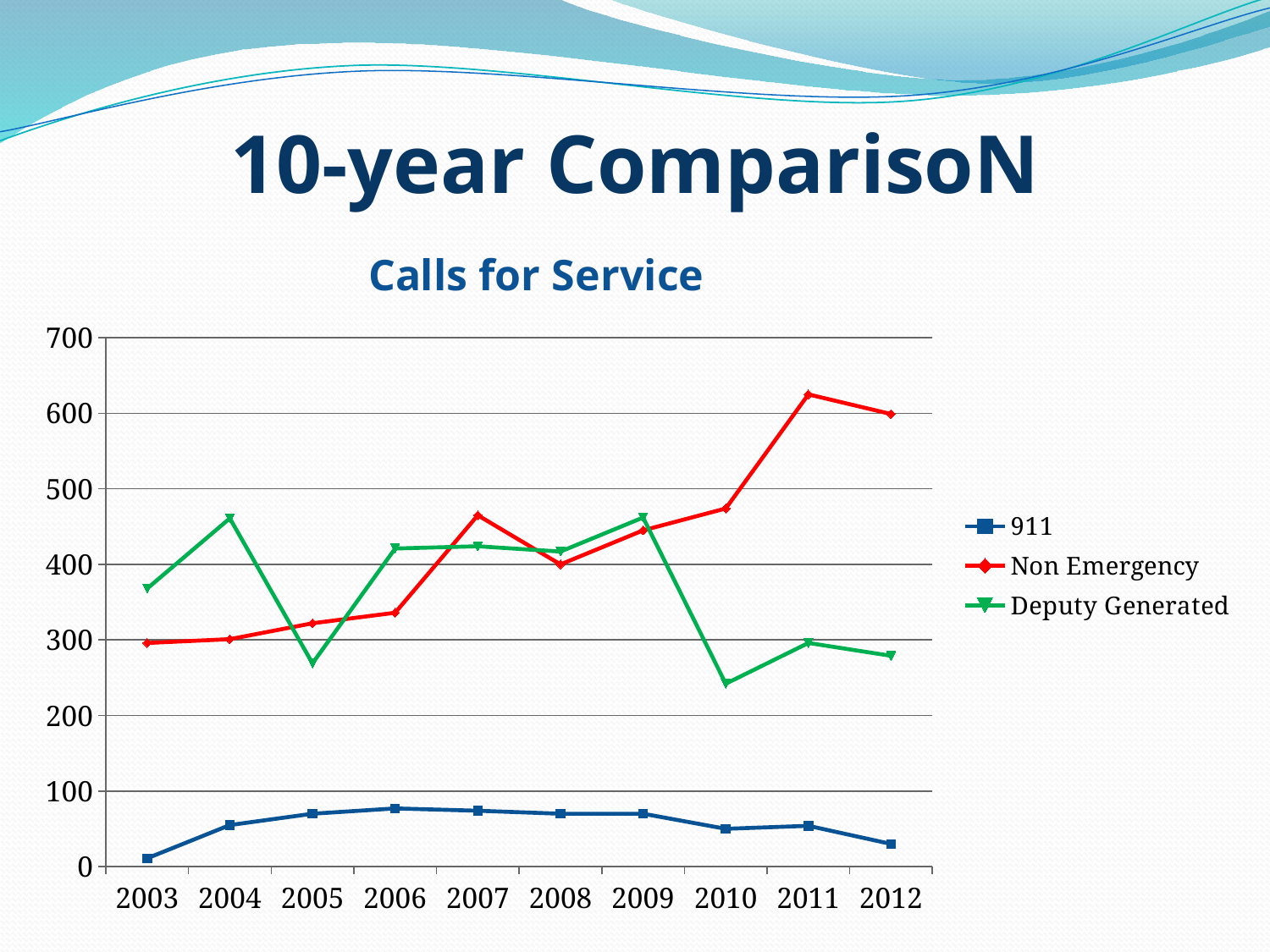
What is the title of the chart? Calls for Service In 2012, which is larger: Non Emergency or Deputy Generated? Non Emergency Is the 911 value for 2006 greater or less than 100? less Is the Deputy Generated value for 2010 greater or less than 300? less How many years are plotted along the x axis? 10 How many series does the legend list? 3 What kind of chart is shown on the slide? line chart In which year is the Non Emergency series at its highest? 2011 In which year is the 911 series at its lowest? 2003 Is the Non Emergency value for 2011 greater or less than 600? greater In which year is the Deputy Generated series at its lowest? 2010 In 2004, which is larger: Deputy Generated or Non Emergency? Deputy Generated